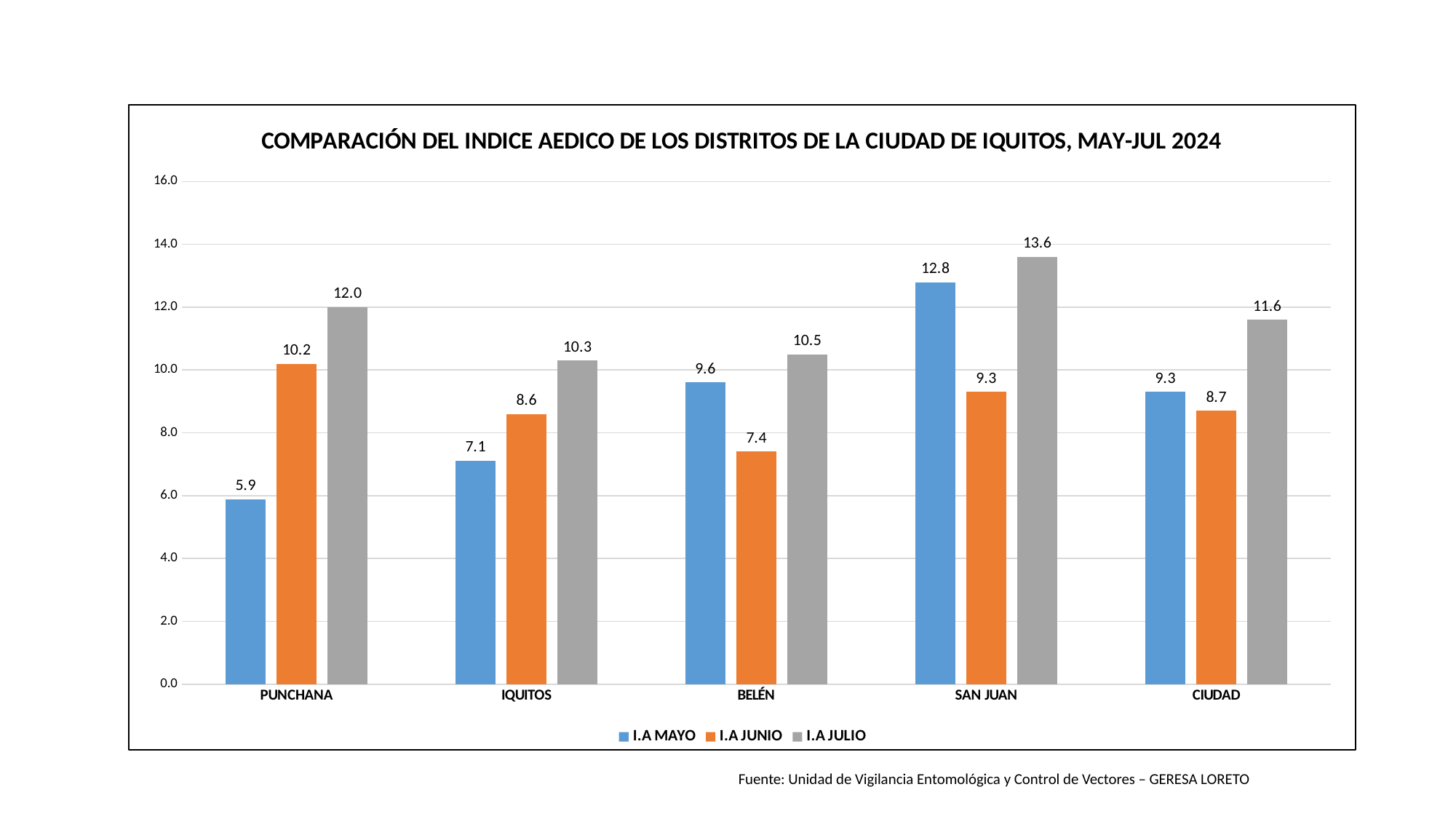
Which district has the highest I.A MAYO value? SAN JUAN What kind of chart is shown on the slide? Bar chart What colour represents the I.A JULIO series? Grey Is the I.A JULIO value for CIUDAD greater or less than 10.0? greater How many series does the legend list? 3 What is the I.A JUNIO value for BELÉN? 7.4 What is the difference between the I.A JULIO and I.A MAYO values for PUNCHANA? 6.1 Which category has the lowest I.A JUNIO value? BELÉN Which is larger for IQUITOS: the I.A MAYO value or the I.A JUNIO value? I.A JUNIO How many categories are shown on the x axis? 5 What is the I.A MAYO value for PUNCHANA? 5.9 What is the I.A JULIO value for SAN JUAN? 13.6